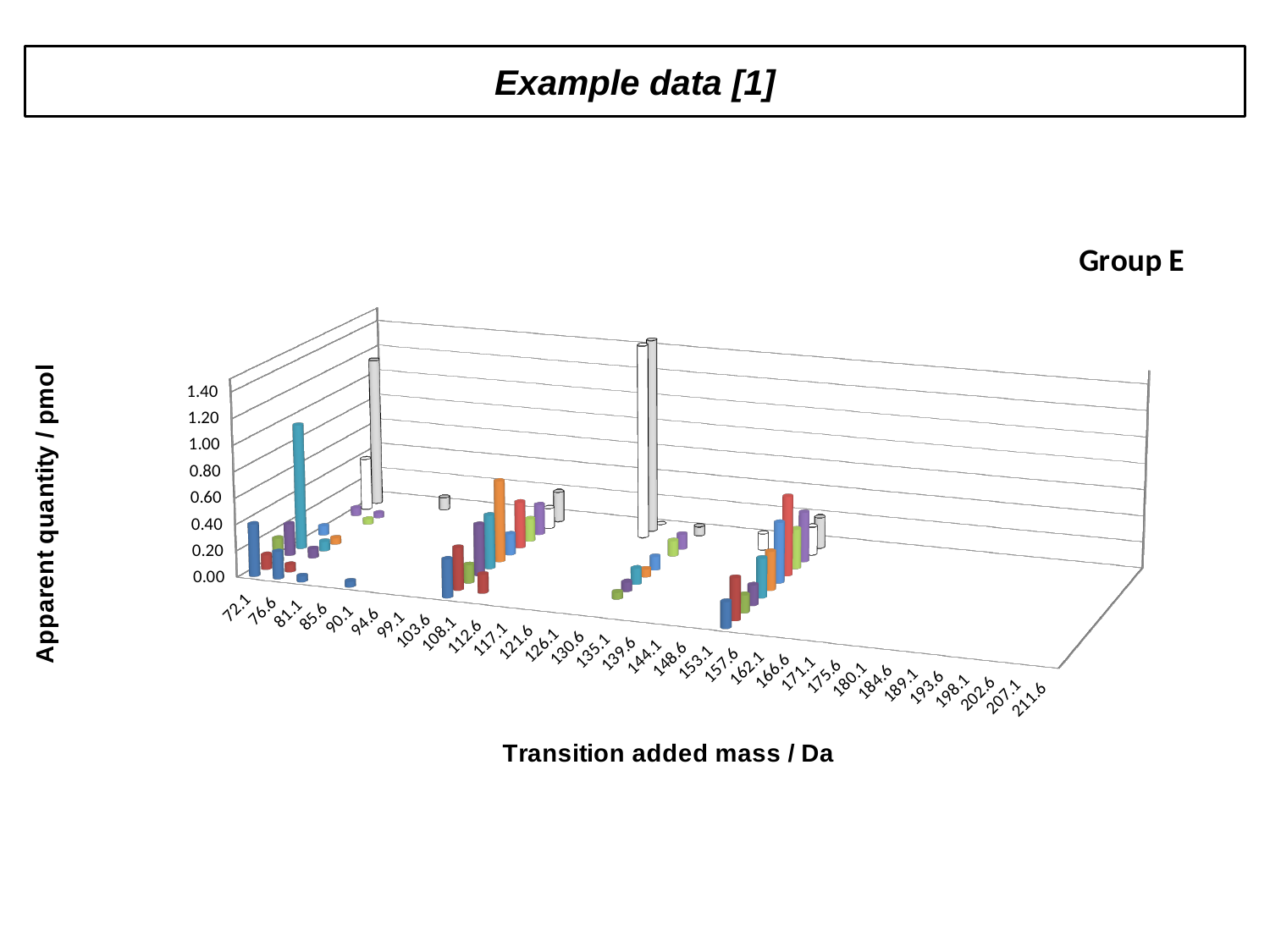
What is the highest tick value shown on the vertical axis of the chart? 1.40 What kind of chart is shown on the slide? bar chart What is the label of the vertical axis of the chart? Apparent quantity / pmol What is the last category label on the x axis of the chart? 211.6 What is the title of the chart? Group E How many categories are labelled along the x axis of the chart? 32 What is the first category label on the x axis of the chart? 72.1